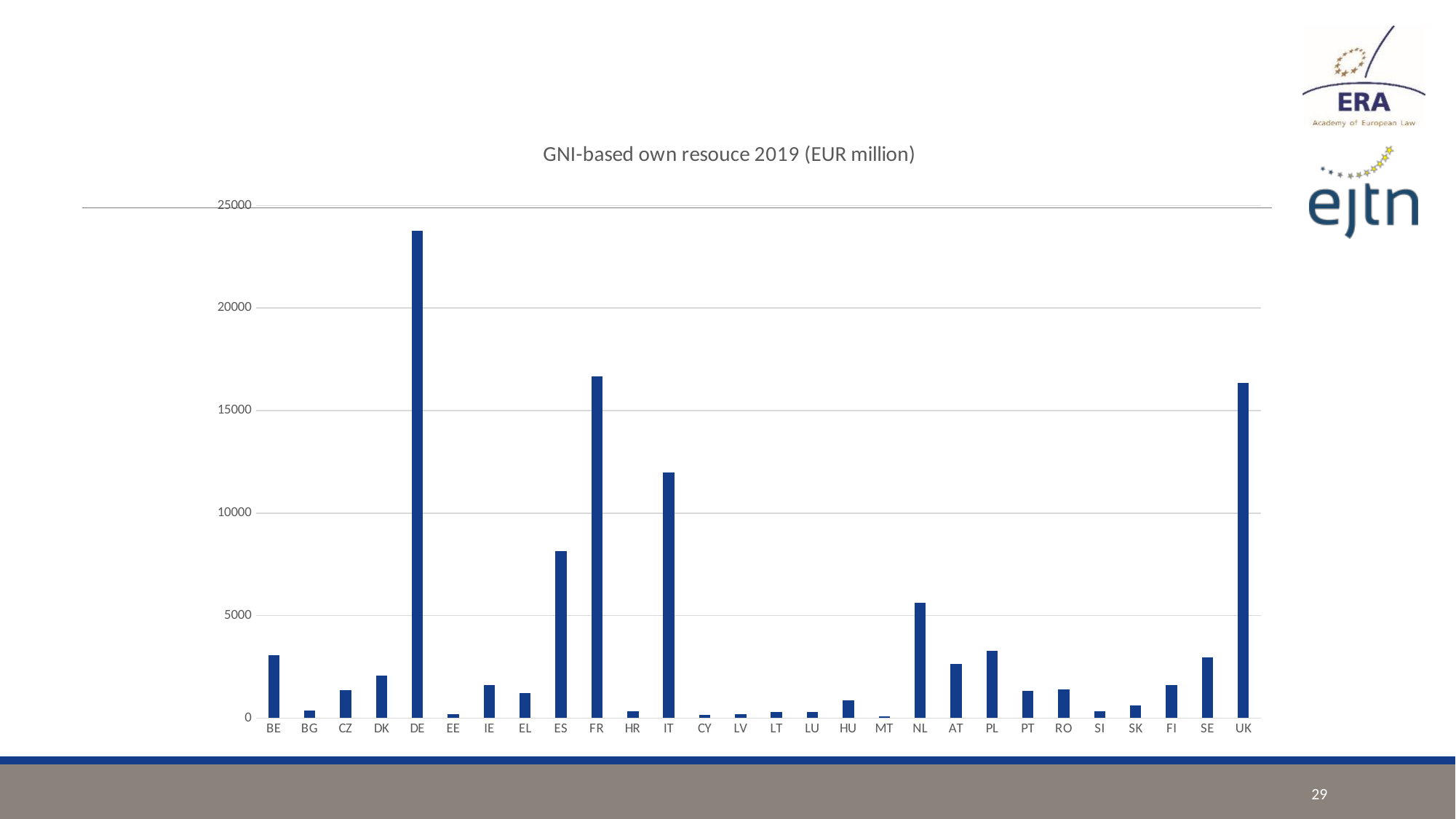
What is the title of the chart? GNI-based own resouce 2019 (EUR million) Which country has the lowest GNI-based own resource in 2019? MT Is the value for NL greater or less than 5000? greater Is the value for FR greater or less than 15000? greater Is the value for ES greater or less than 10000? less Which has a larger value, FR or IT? FR What type of chart is shown on the slide? bar chart Which country has the highest GNI-based own resource in 2019? DE Which has a larger value, ES or NL? ES How many countries are shown on the x axis of the chart? 28